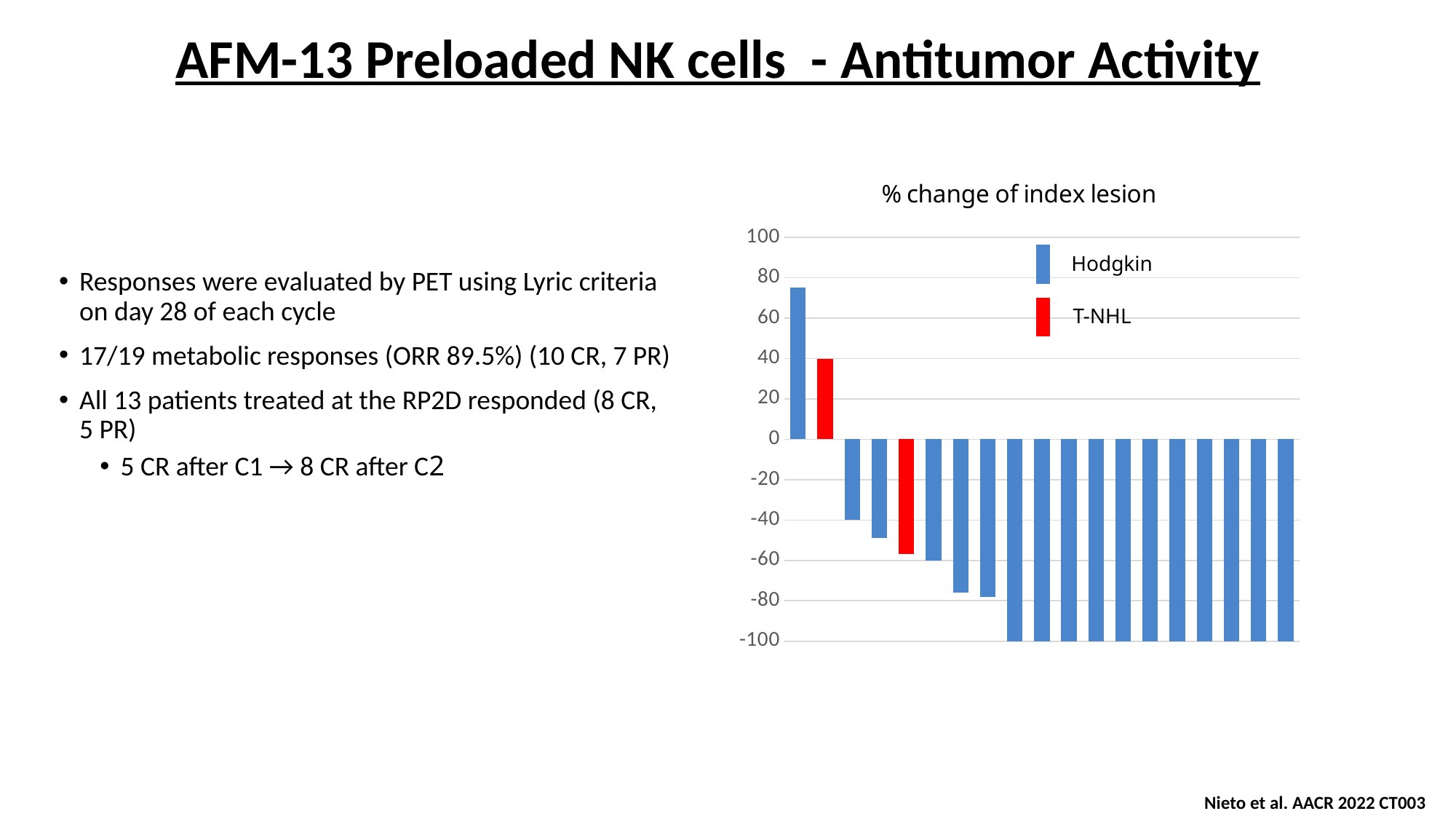
What type of chart is shown on the slide? bar chart Do the bar values rise or fall from left to right across the chart? fall Is the value of the leftmost (tallest positive) bar greater or less than 60? greater How many bars reach the -100 line in the chart? 11 Is the value of the first red (T-NHL) bar greater or less than 60? less How many series does the chart legend list? 2 What value do the lowest bars in the chart reach? -100 Which series is shown in red in the chart? T-NHL How many red (T-NHL) bars are in the chart? 2 How many bars (patients) are plotted in the chart? 19 Which is larger, the leftmost blue bar or the first red bar? the leftmost blue bar What is the title of the chart? % change of index lesion